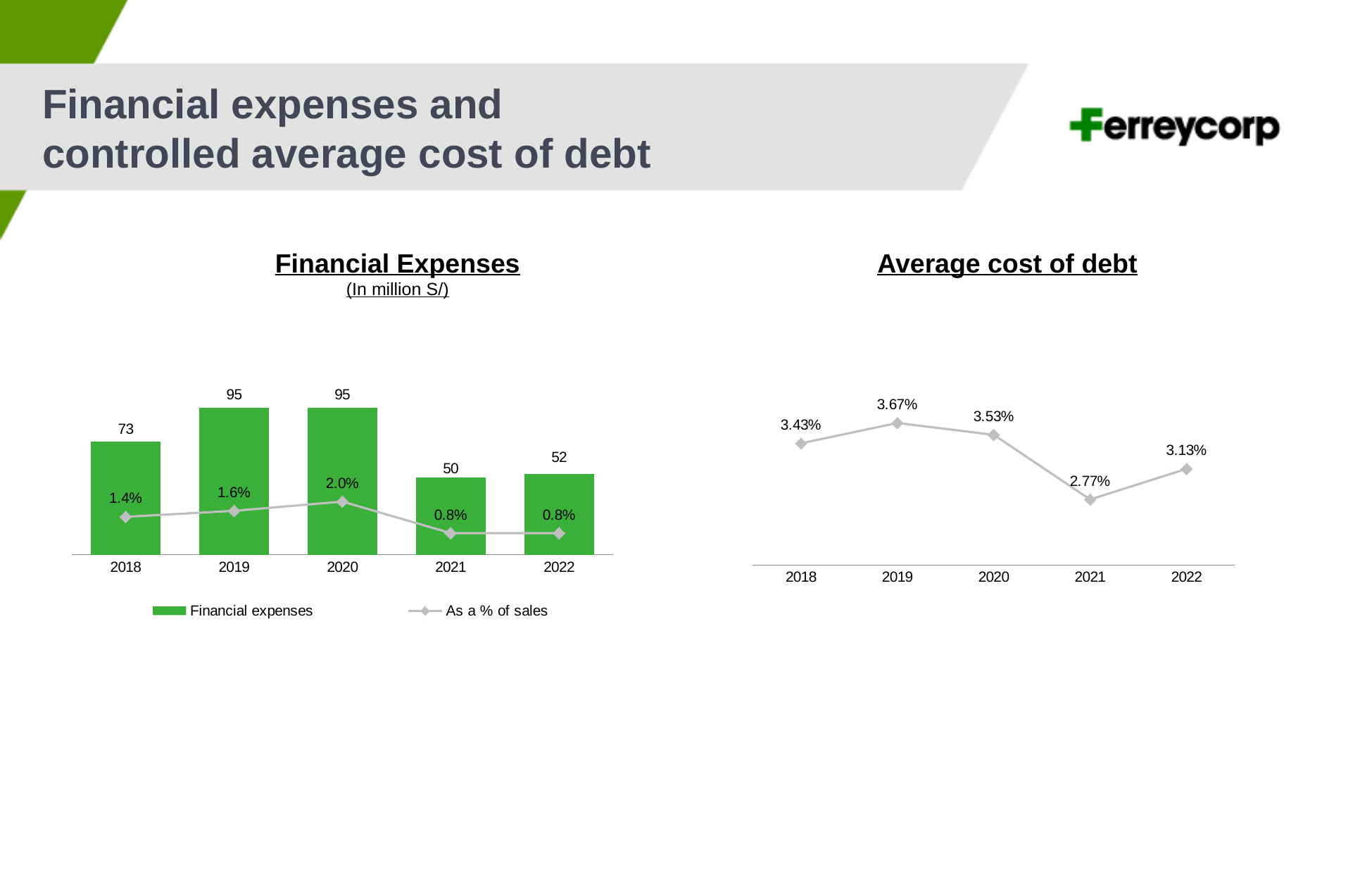
In the Financial Expenses chart, are financial expenses higher in 2018 or in 2022? 2018 In the Financial Expenses chart, what unit is stated under the title? In million S/ In the Financial Expenses chart, what is the 'As a % of sales' value for 2020? 2.0% In the Financial Expenses chart, which year has the lowest financial expenses? 2021 In the Average cost of debt chart, what is the difference between the 2019 and 2022 values? 0.54% In the Financial Expenses chart, what is the difference in financial expenses between 2020 and 2021? 45 In the Average cost of debt chart, which year has the highest average cost of debt? 2019 In the Financial Expenses chart, what is the value of financial expenses for 2018? 73 What kind of chart is the Average cost of debt chart? Line chart In the Financial Expenses chart, how many years are shown on the x axis? 5 In the Average cost of debt chart, what is the value for 2021? 2.77% In the Financial Expenses chart, how many series does the legend list? 2